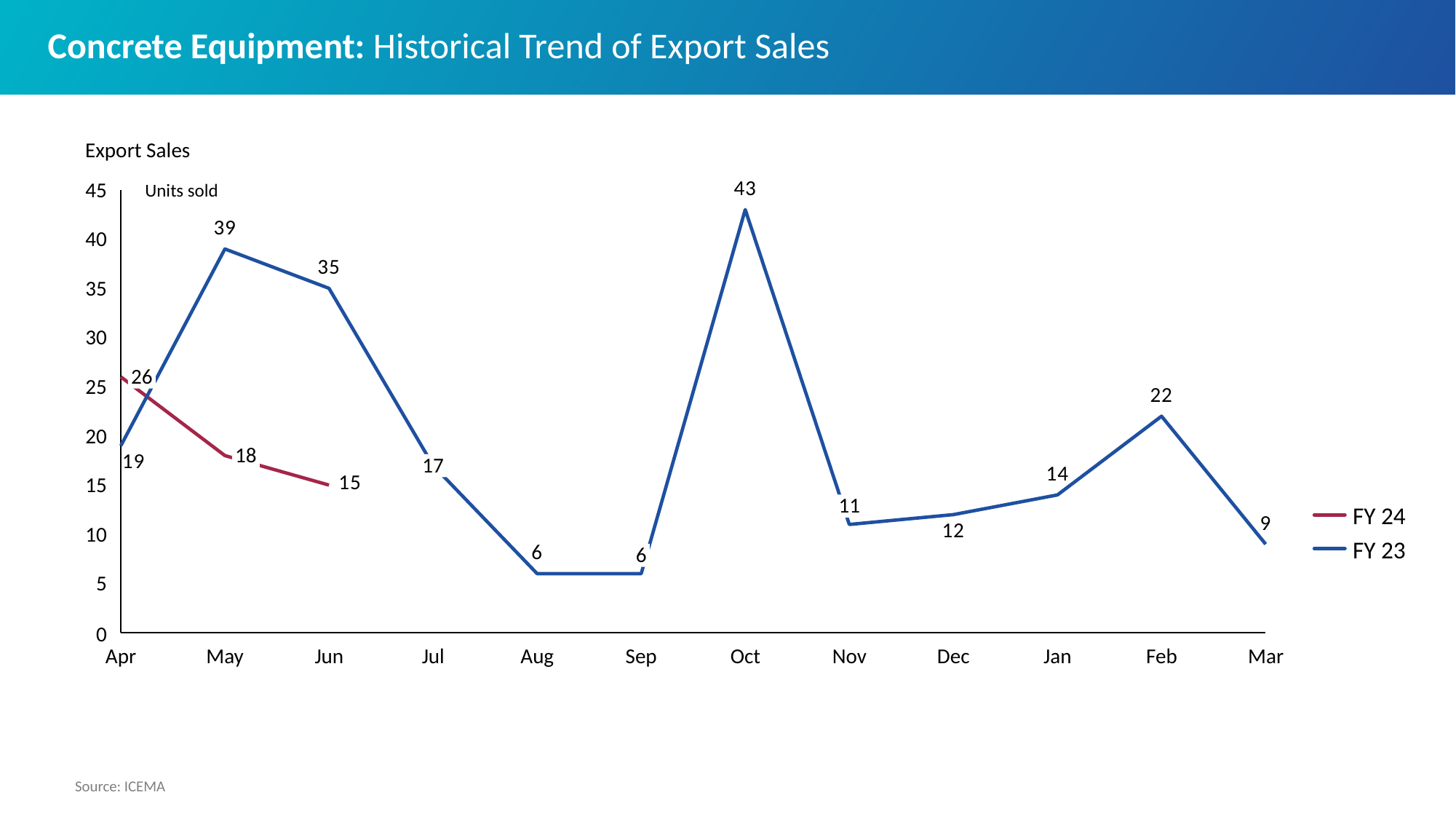
Do FY 24 export sales rise or fall from April to June? Fall What is the difference between FY 23 and FY 24 export sales in June? 20 What is the difference between FY 23 export sales in May and in June? 4 What is the lowest FY 23 export sales value shown? 6 What is the source cited for the chart? ICEMA Which is larger, FY 24 export sales in April or FY 23 export sales in April? FY 24 What kind of chart is shown on the slide? Line chart In which month were FY 23 export sales highest? Oct How many months are shown on the x axis? 12 How many series does the legend list? 2 What was the FY 23 export sales value in October? 43 What was the FY 24 export sales value in April? 26